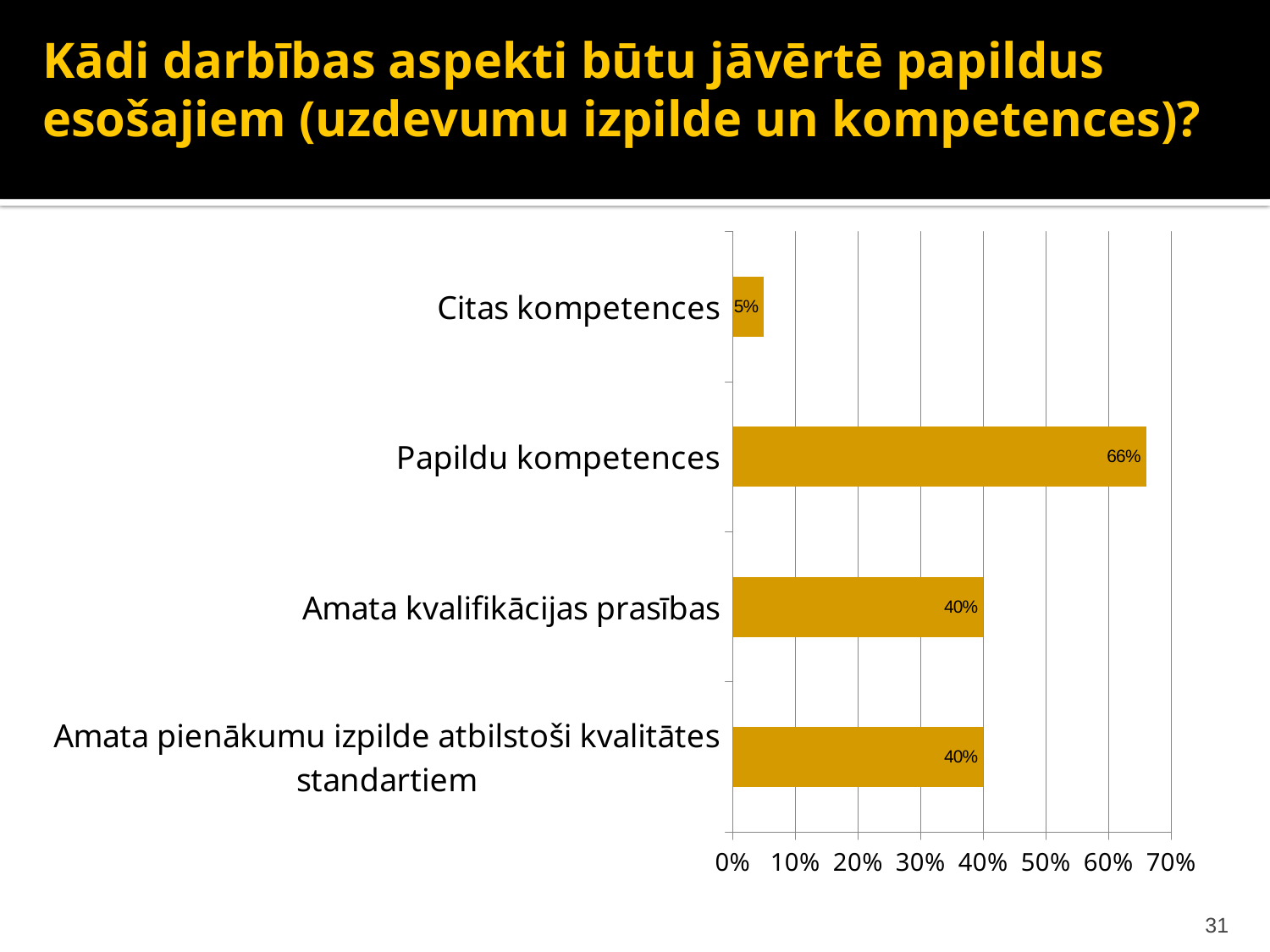
How many categories are shown in the chart? 4 Which is larger, the value for Papildu kompetences or the value for Amata kvalifikācijas prasības? Papildu kompetences Is the value for Papildu kompetences greater or less than 60%? greater Which category has the highest value? Papildu kompetences What is the value for Citas kompetences? 5% What kind of chart is shown on the slide? bar chart What is the difference between the values for Papildu kompetences and Citas kompetences? 61% What is the value for Amata pienākumu izpilde atbilstoši kvalitātes standartiem? 40% What is the difference between the values for Papildu kompetences and Amata kvalifikācijas prasības? 26% What is the value for Amata kvalifikācijas prasības? 40% What is the value for Papildu kompetences? 66% Which category has the lowest value? Citas kompetences